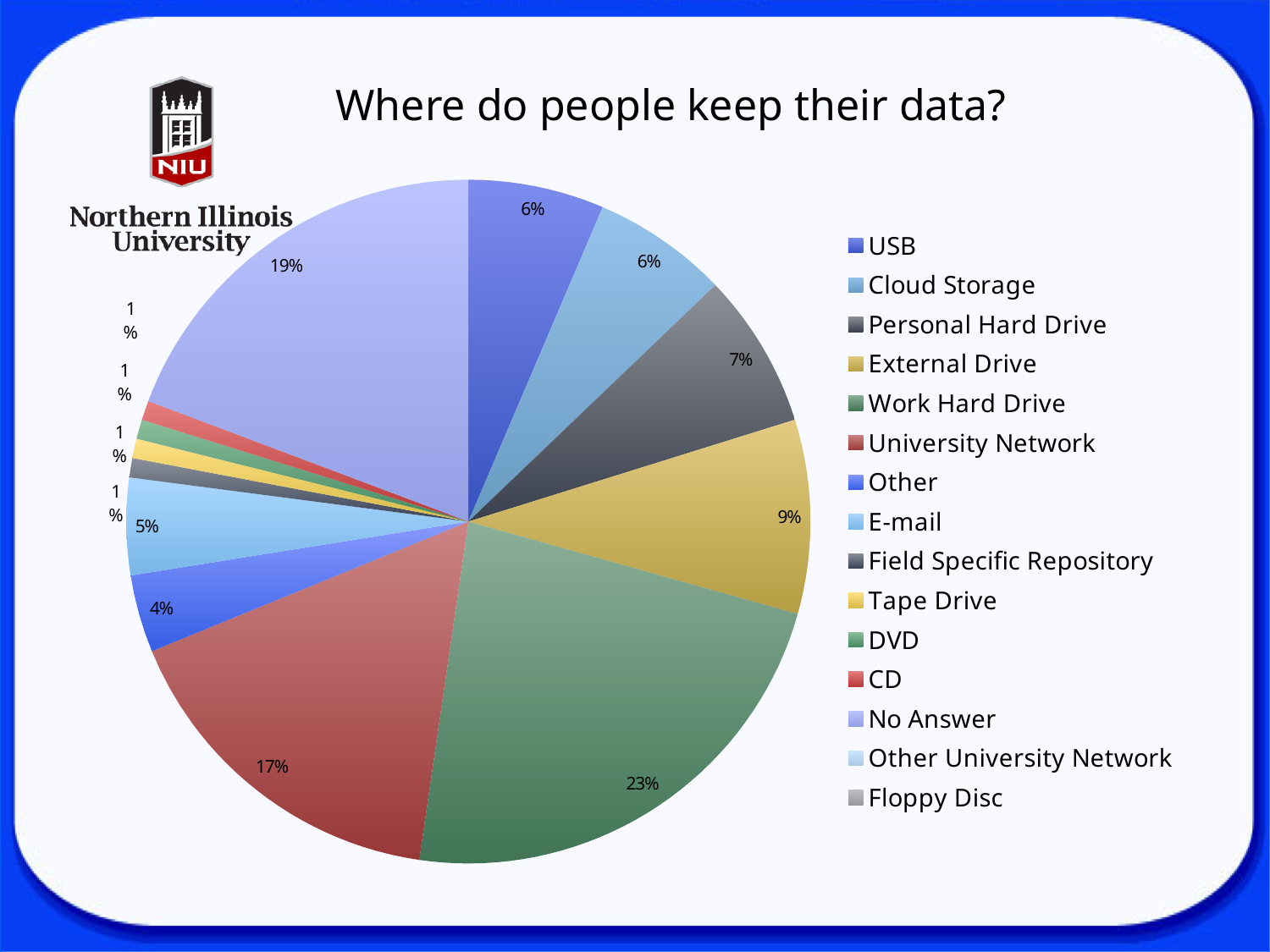
What is the difference in percentage points between the Work Hard Drive share and the University Network share? 6 What share of the pie does Personal Hard Drive represent? 7% What kind of chart is shown on the slide? Pie chart What share of the pie does External Drive represent? 9% Which is larger, the share for University Network or the share for No Answer? No Answer What share of the pie does No Answer represent? 19% Which category has the largest slice of the pie? Work Hard Drive How many entries does the legend list? 15 What is the title of the slide? Where do people keep their data?